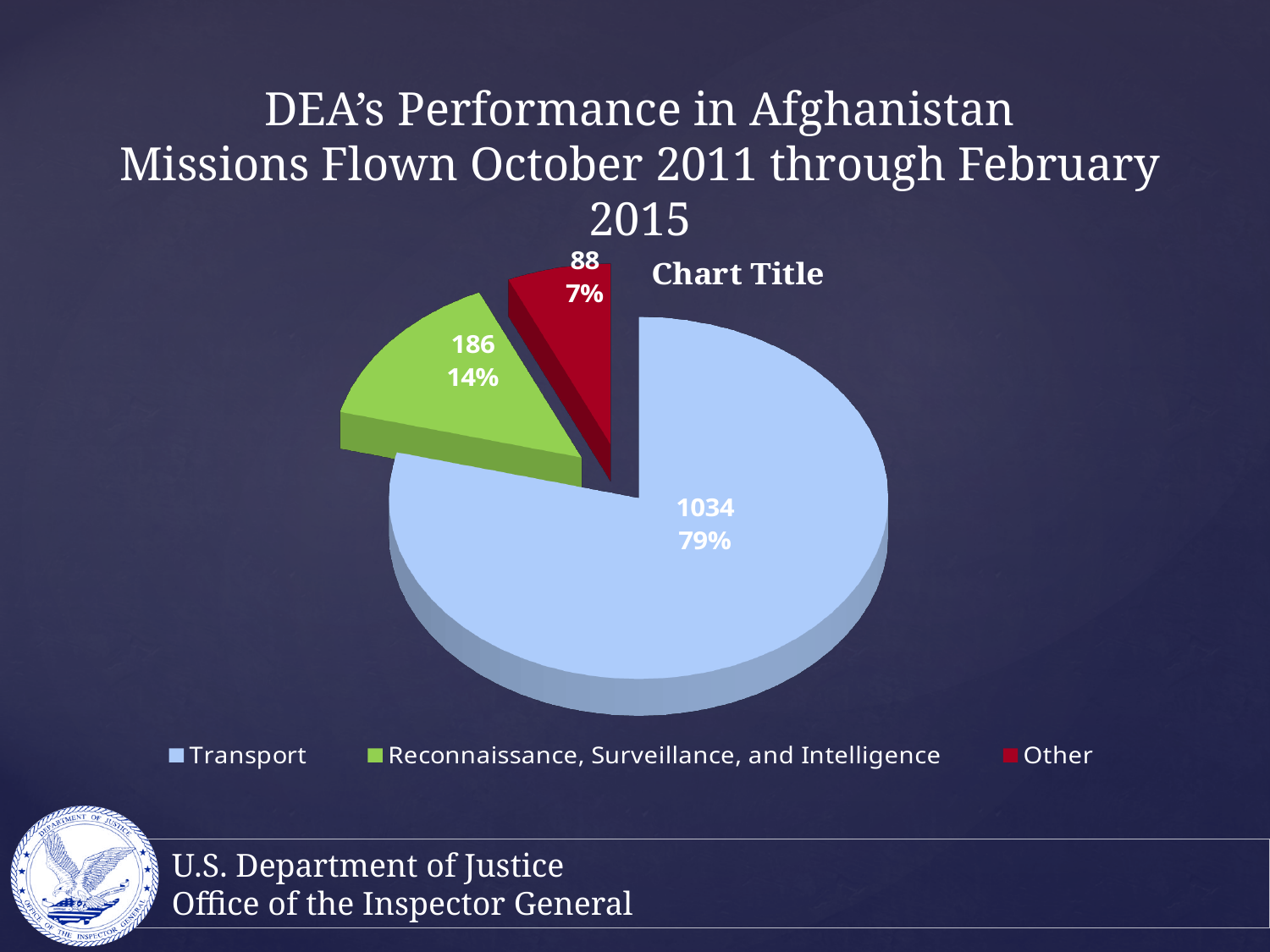
What share of the pie does Reconnaissance, Surveillance, and Intelligence represent? 14% Which category has the highest number of missions? Transport What share of the pie does Transport represent? 79% What kind of chart is shown on the slide? Pie chart How many missions were flown for Reconnaissance, Surveillance, and Intelligence? 186 How many missions were flown in the Other category? 88 How many categories does the legend list? 3 What is the difference in missions between Transport and Reconnaissance, Surveillance, and Intelligence? 848 Which has more missions, Reconnaissance, Surveillance, and Intelligence or Other? Reconnaissance, Surveillance, and Intelligence What share of the pie does Other represent? 7% How many missions were flown for Transport? 1034 Which category has the lowest number of missions? Other